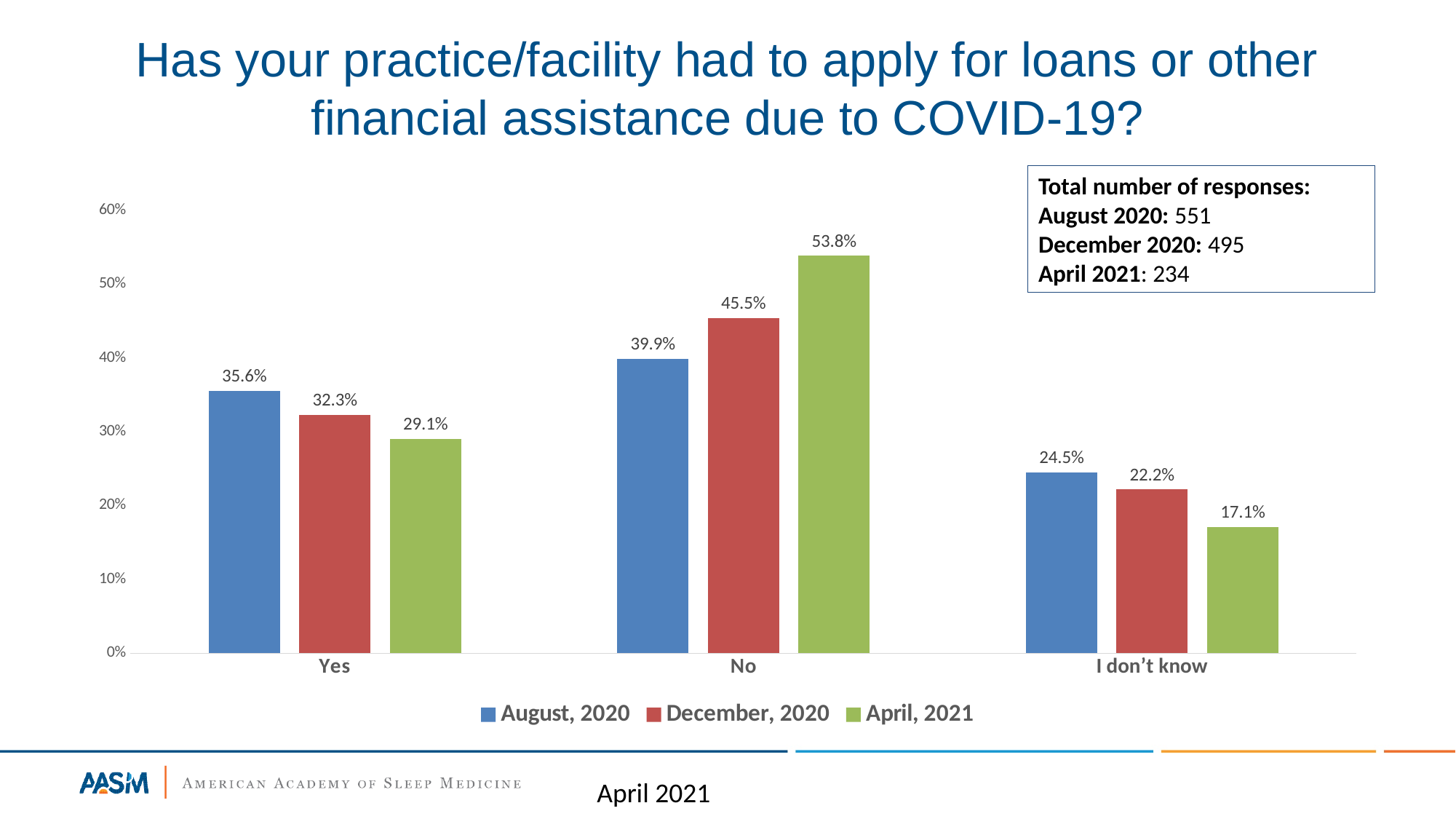
What kind of chart is shown on the slide? Bar chart How many series does the legend list? 3 Which response category has the highest value for April, 2021? No Across the three survey dates, does the "I don't know" value rise or fall from August, 2020 to April, 2021? Fall According to the text box, how many responses were there in December 2020? 495 What is the difference between the April, 2021 and August, 2020 values for "No"? 13.9% How many response categories are shown on the x axis? 3 Which response category has the lowest value for August, 2020? I don't know What percentage of respondents answered "Yes" in August, 2020? 35.6% What is the value for "I don't know" in December, 2020? 22.2% Which is larger for "Yes": the December, 2020 value or the April, 2021 value? December, 2020 What percentage of respondents answered "No" in April, 2021? 53.8%